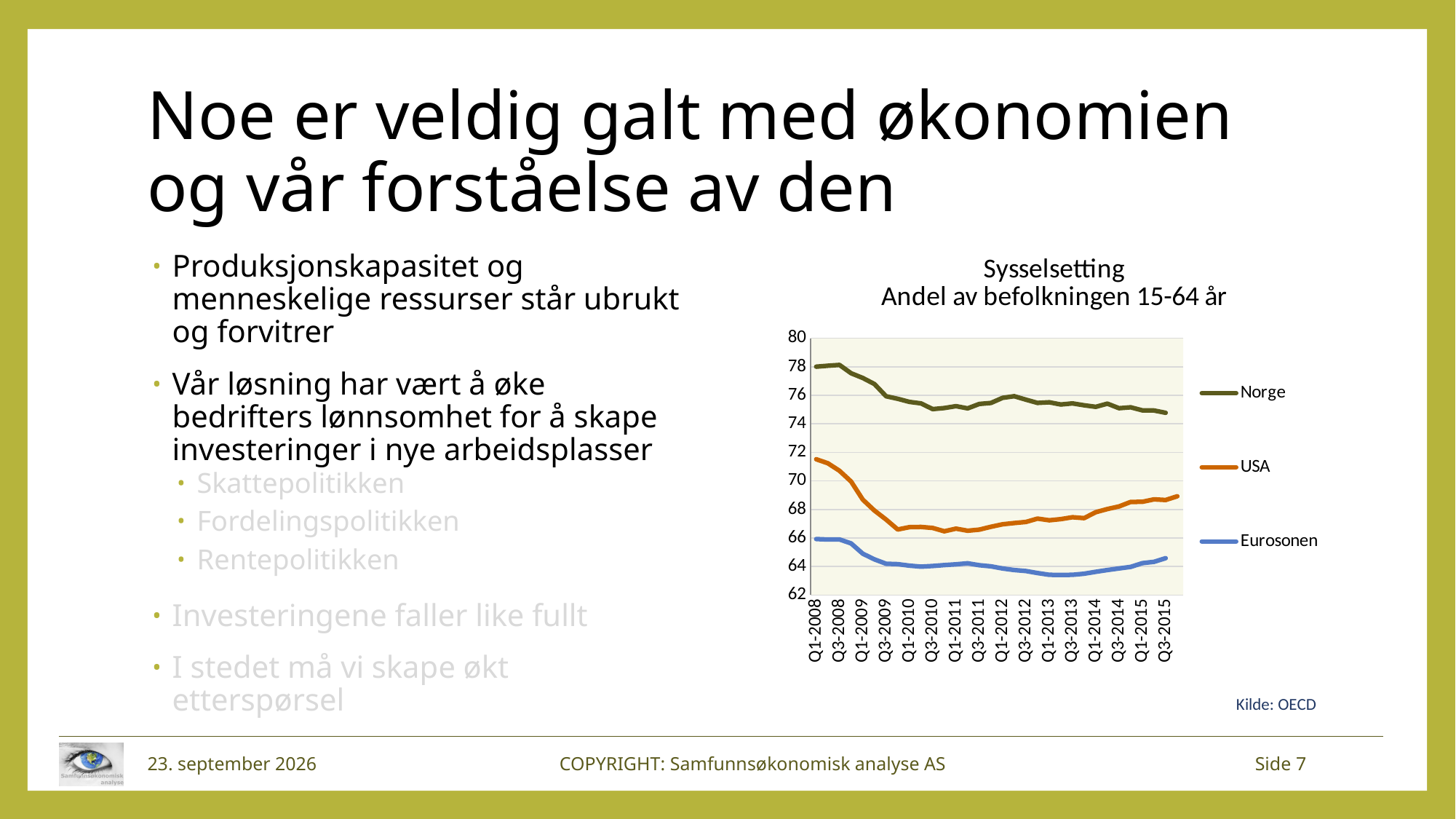
Which series has the highest employment share throughout the chart? Norge Is the value for USA at Q1-2008 greater or less than 70? greater Does the USA series rise or fall from Q1-2010 to Q3-2015? Rises What source is cited below the chart? Kilde: OECD Is the value for Norge at Q1-2008 greater or less than 76? greater How many series does the chart legend list? 3 Does the Norge series rise or fall from Q1-2008 to Q3-2015? Falls What is the title of the chart? Sysselsetting – Andel av befolkningen 15-64 år Which series has the lowest employment share throughout the chart? Eurosonen Is the value for Norge at Q3-2015 greater or less than 76? less What kind of chart is shown on the slide? Line chart